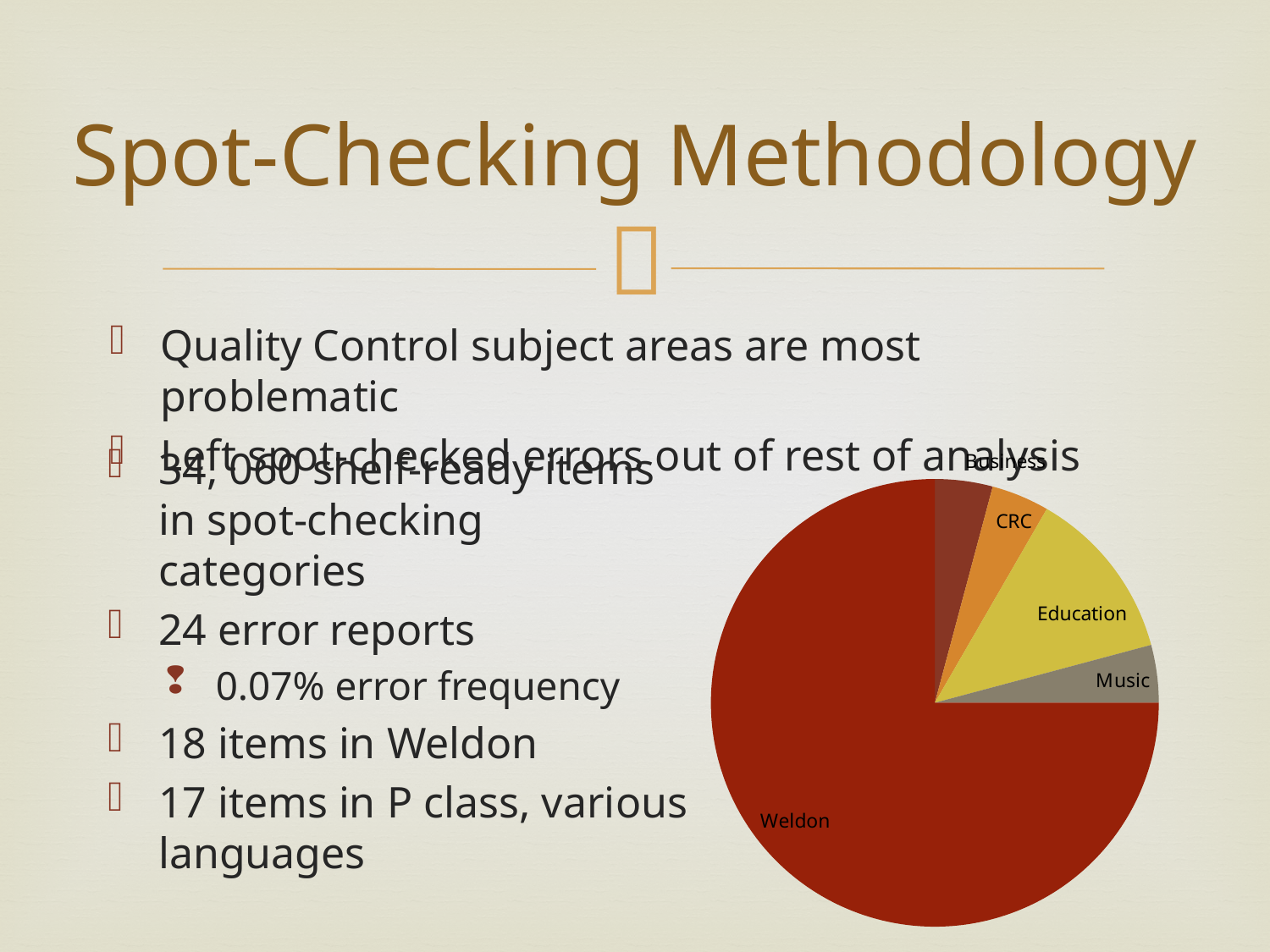
What colour is the Weldon slice in the pie chart? dark red Does the Weldon slice account for more or less than half of the pie chart? more Which category is the second-largest slice in the pie chart? Education How many slices does the pie chart have? 5 Which slice is larger in the pie chart, Education or Music? Education What kind of chart is shown on the slide? pie chart Which slice is larger in the pie chart, Education or CRC? Education What colour is the Education slice in the pie chart? yellow Which category has the largest slice in the pie chart? Weldon Which slice is larger in the pie chart, Weldon or Education? Weldon